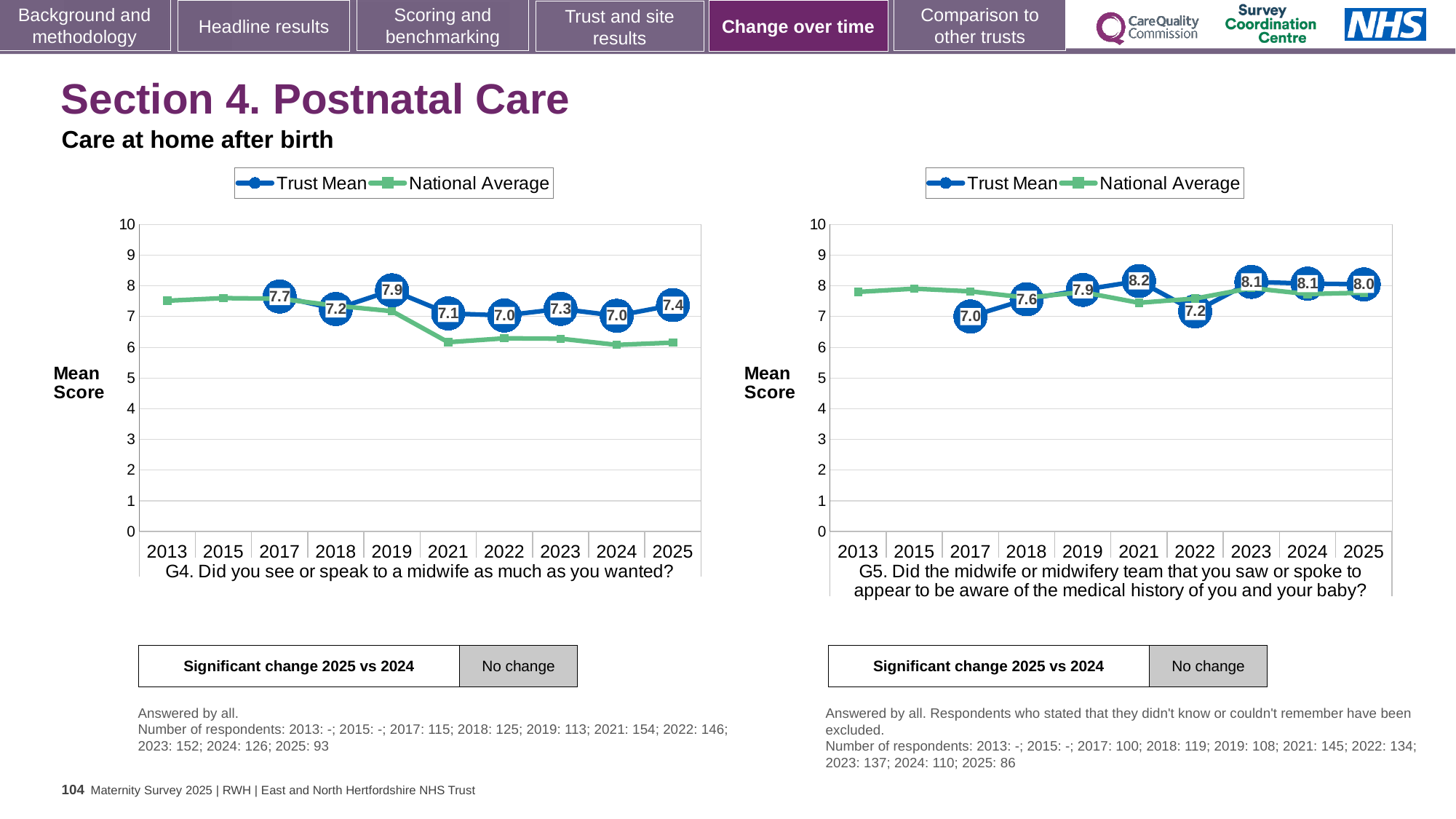
In the G4 chart on the left, what is the Trust Mean for 2025? 7.4 What kind of chart is the G4 chart on the left? Line chart In the G5 chart on the right, what is the Trust Mean for 2021? 8.2 In the G5 chart on the right, is the National Average for 2013 greater or less than 7? greater In the G4 chart on the left, is the Trust Mean higher in 2019 or in 2018? 2019 In the G5 chart on the right, which year has the lowest Trust Mean? 2017 How many series does the legend of the G5 chart on the right list? 2 In the G4 chart on the left, is the National Average for 2025 greater or less than 7? less In the G5 chart on the right, what is the difference between the Trust Mean in 2021 and in 2022? 1.0 In the G4 chart on the left, which year has the highest Trust Mean? 2019 In the G4 chart on the left, does the Trust Mean rise or fall from 2024 to 2025? rise How many years are shown on the x axis of the G4 chart on the left? 10